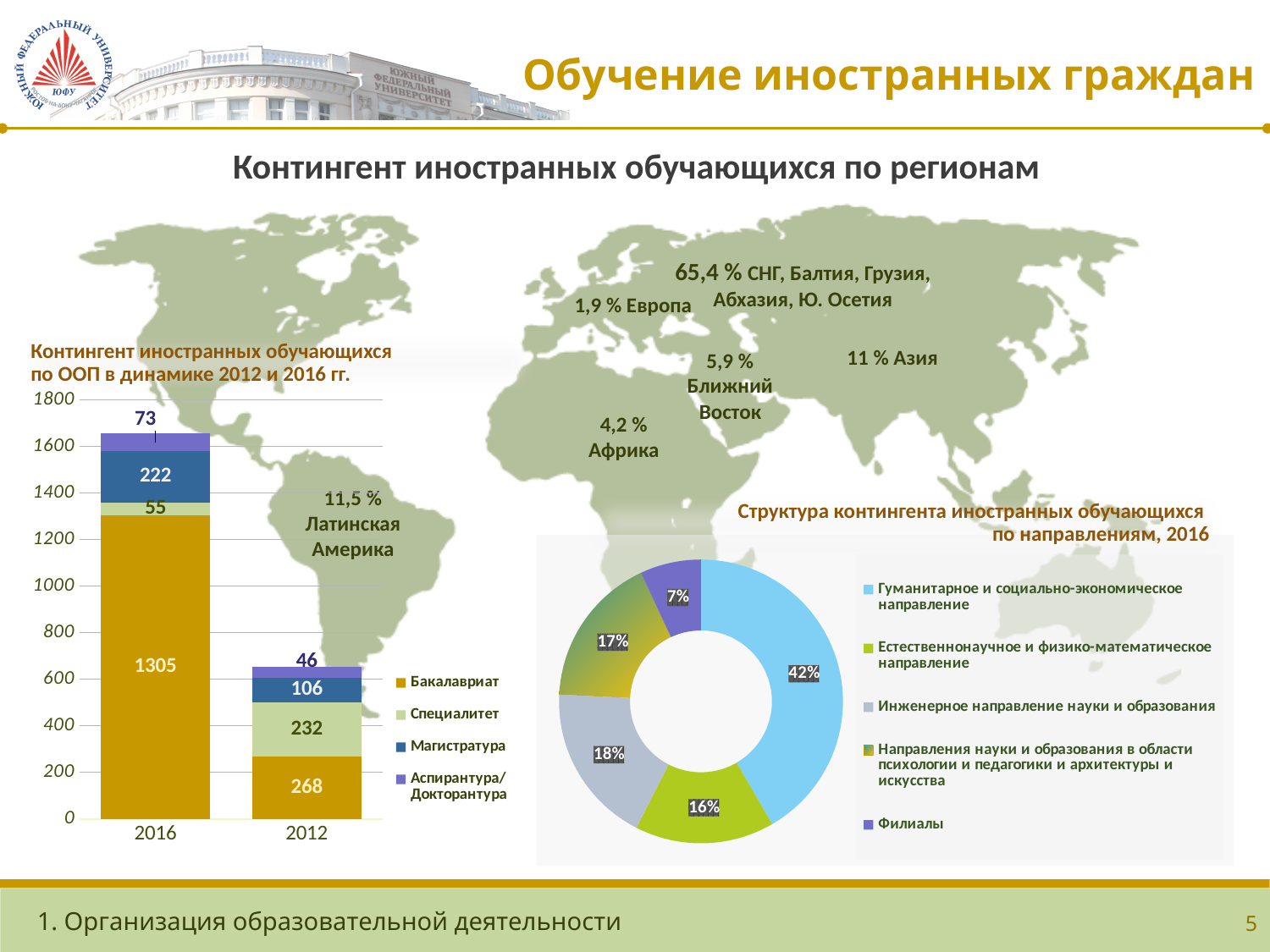
In the stacked bar chart 'Контингент иностранных обучающихся по ООП в динамике 2012 и 2016 гг.', what is the value for Магистратура in 2016? 222 In the stacked bar chart 'Контингент иностранных обучающихся по ООП в динамике 2012 и 2016 гг.', what is the difference between the Бакалавриат values for 2016 and 2012? 1037 In the chart 'Структура контингента иностранных обучающихся по направлениям, 2016', which category has the smallest share? Филиалы In the stacked bar chart 'Контингент иностранных обучающихся по ООП в динамике 2012 и 2016 гг.', what is the total of the 2016 bar? 1655 In the stacked bar chart 'Контингент иностранных обучающихся по ООП в динамике 2012 и 2016 гг.', which year has the larger Аспирантура/Докторантура value, 2016 or 2012? 2016 In the stacked bar chart 'Контингент иностранных обучающихся по ООП в динамике 2012 и 2016 гг.', what is the total of the 2012 bar? 652 In the chart 'Структура контингента иностранных обучающихся по направлениям, 2016', what share does Инженерное направление науки и образования have? 18% In the stacked bar chart 'Контингент иностранных обучающихся по ООП в динамике 2012 и 2016 гг.', what is the value for Бакалавриат in 2016? 1305 In the chart 'Структура контингента иностранных обучающихся по направлениям, 2016', what share does Гуманитарное и социально-экономическое направление have? 42% In the stacked bar chart 'Контингент иностранных обучающихся по ООП в динамике 2012 и 2016 гг.', what is the value for Специалитет in 2012? 232 What kind of chart is 'Структура контингента иностранных обучающихся по направлениям, 2016'? Doughnut (pie) chart In the stacked bar chart 'Контингент иностранных обучающихся по ООП в динамике 2012 и 2016 гг.', how many series does the legend list? 4